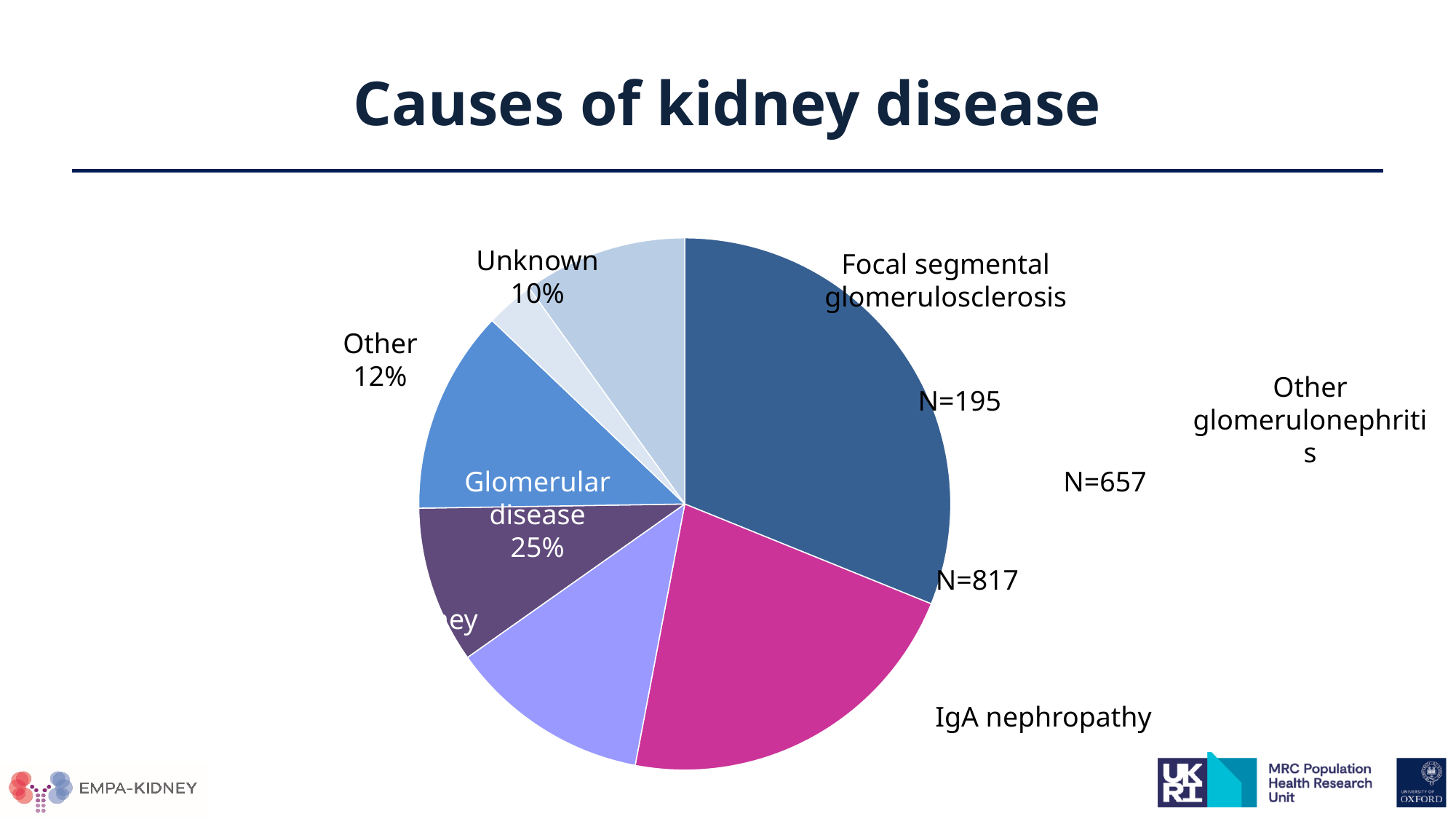
What is the difference in percentage points between the Other share and the Unknown share? 2 percentage points What percentage of the pie is labelled Glomerular disease? 25% Which share is larger, Glomerular disease or Unknown? Glomerular disease What is the title of the chart? Causes of kidney disease What kind of chart is shown on the slide? Pie chart How many slices does the pie chart have? 7 Which of the labelled shares is the smallest: Unknown, Other or Glomerular disease? Unknown Which share is larger, Other or Unknown? Other What percentage of the pie is labelled Other? 12% What percentage of the pie is labelled Unknown? 10% What is the difference in percentage points between the Glomerular disease share and the Other share? 13 percentage points